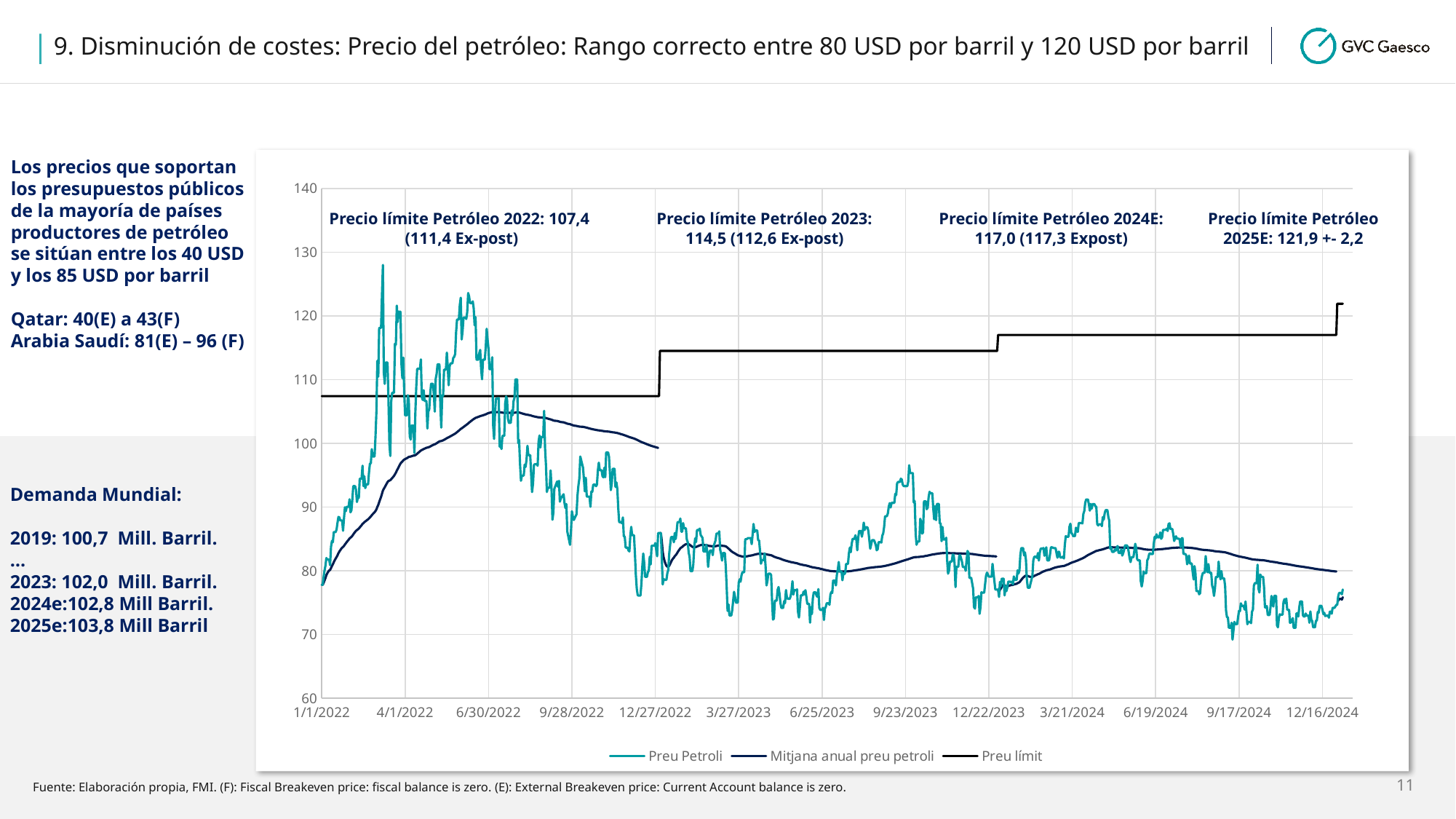
Does the Preu límit line rise or fall along the x axis from 2022 to 2025? Rise According to the chart annotation, what is the Precio límite Petróleo for 2024E? 117,0 Is the Preu Petroli value around 9/17/2024 greater or less than 80? less How many series does the chart legend list? 3 According to the chart annotation, what is the Precio límite Petróleo for 2023? 114,5 According to the chart annotation, what is the Precio límite Petróleo for 2025E? 121,9 +- 2,2 What are the three series named in the chart legend? Preu Petroli, Mitjana anual preu petroli, Preu límit Which year has the highest Precio límite Petróleo shown in the annotations: 2022, 2023, 2024E or 2025E? 2025E Which is larger, the Precio límite Petróleo for 2024E or for 2023? 2024E According to the chart annotation, what is the Precio límite Petróleo for 2022? 107,4 By how much does the Precio límite Petróleo for 2023 (114,5) exceed the one for 2022 (107,4)? 7,1 What kind of chart is shown on the slide? Line chart